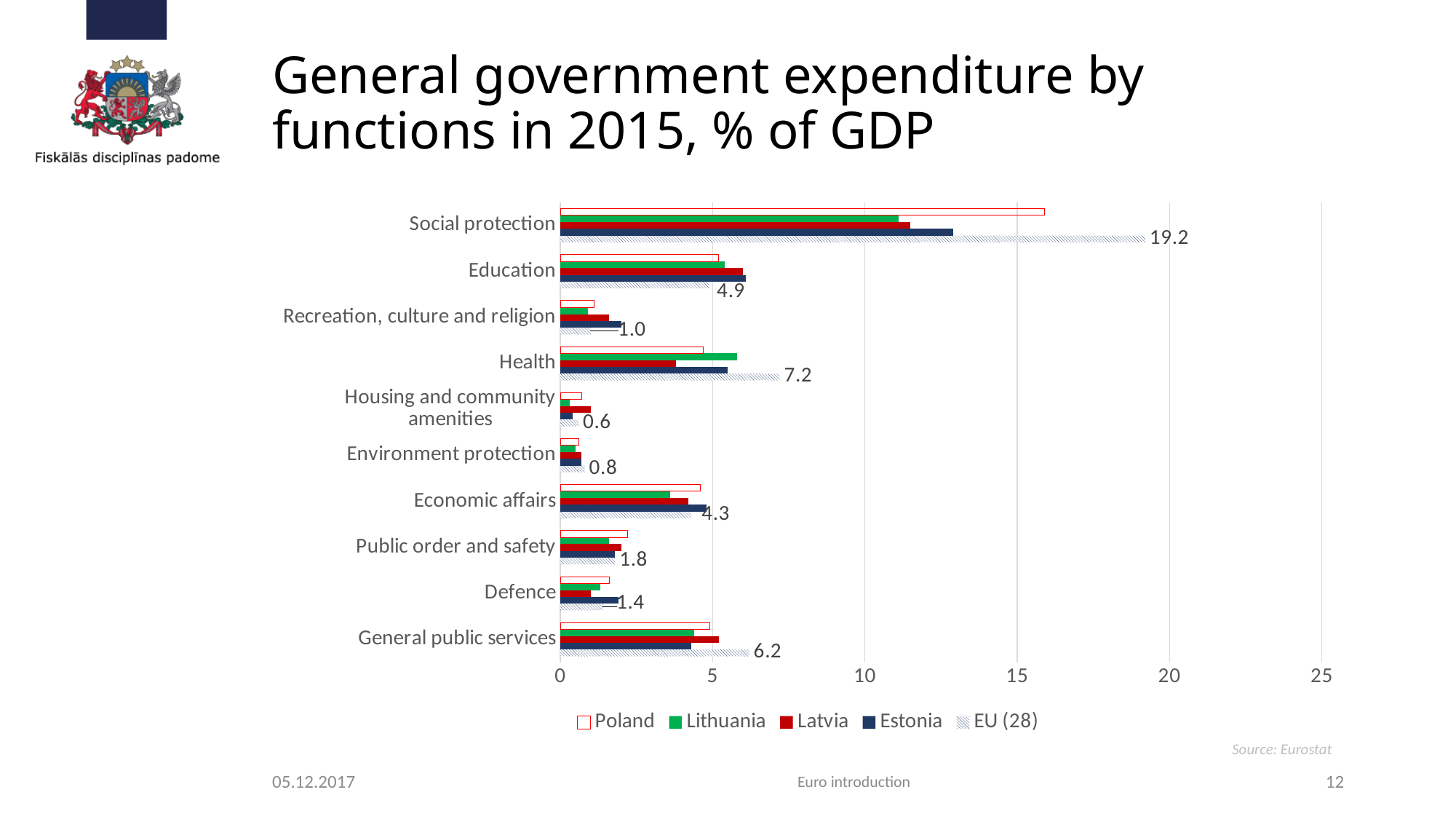
What is the EU (28) value for Social protection? 19.2 Is the value for Estonia in Social protection greater or less than 15? less Which function has the highest EU (28) value? Social protection Which function has the lowest EU (28) value? Housing and community amenities What kind of chart is shown on the slide? Bar chart How many functions (categories) are shown on the chart? 10 What is the EU (28) value for Health? 7.2 What is the EU (28) value for General public services? 6.2 How many series does the legend list? 5 What is the difference between the EU (28) values for Health and Education? 2.3 Which has the larger EU (28) value, Health or General public services? Health Is the value for Poland in Social protection greater or less than 15? greater